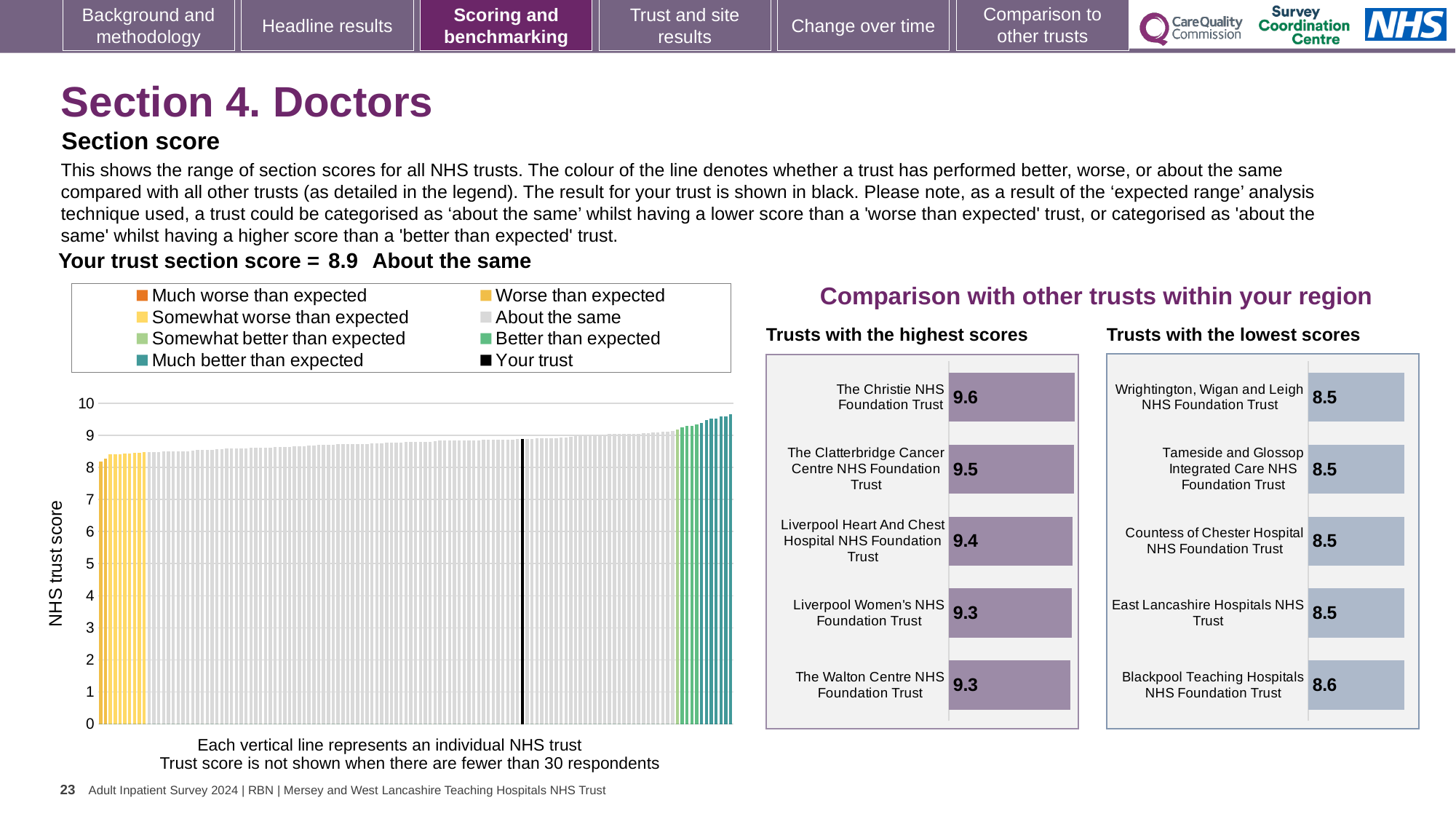
In the 'Trusts with the highest scores' chart, what is the score for The Christie NHS Foundation Trust? 9.6 In the 'Trusts with the highest scores' chart, what is the difference between the scores of The Christie NHS Foundation Trust and The Walton Centre NHS Foundation Trust? 0.3 In the 'Trusts with the highest scores' chart, which has the larger score: The Clatterbridge Cancer Centre NHS Foundation Trust or Liverpool Women's NHS Foundation Trust? The Clatterbridge Cancer Centre NHS Foundation Trust In the main chart of NHS trust scores, do the values rise or fall from left to right along the x axis? Rise How many entries does the legend of the main NHS trust score chart list? 8 In the 'Trusts with the highest scores' chart, what is the score for Liverpool Heart And Chest Hospital NHS Foundation Trust? 9.4 In the 'Trusts with the highest scores' chart, which trust has the highest score? The Christie NHS Foundation Trust In the main chart of NHS trust scores, is the value for the black bar (your trust) greater or less than 8? greater How many trusts are shown in the 'Trusts with the lowest scores' chart? 5 In the 'Trusts with the lowest scores' chart, which trust has the highest score? Blackpool Teaching Hospitals NHS Foundation Trust What kind of chart is the main chart showing NHS trust scores on the left of the slide? Bar chart In the 'Trusts with the lowest scores' chart, what is the score for Blackpool Teaching Hospitals NHS Foundation Trust? 8.6